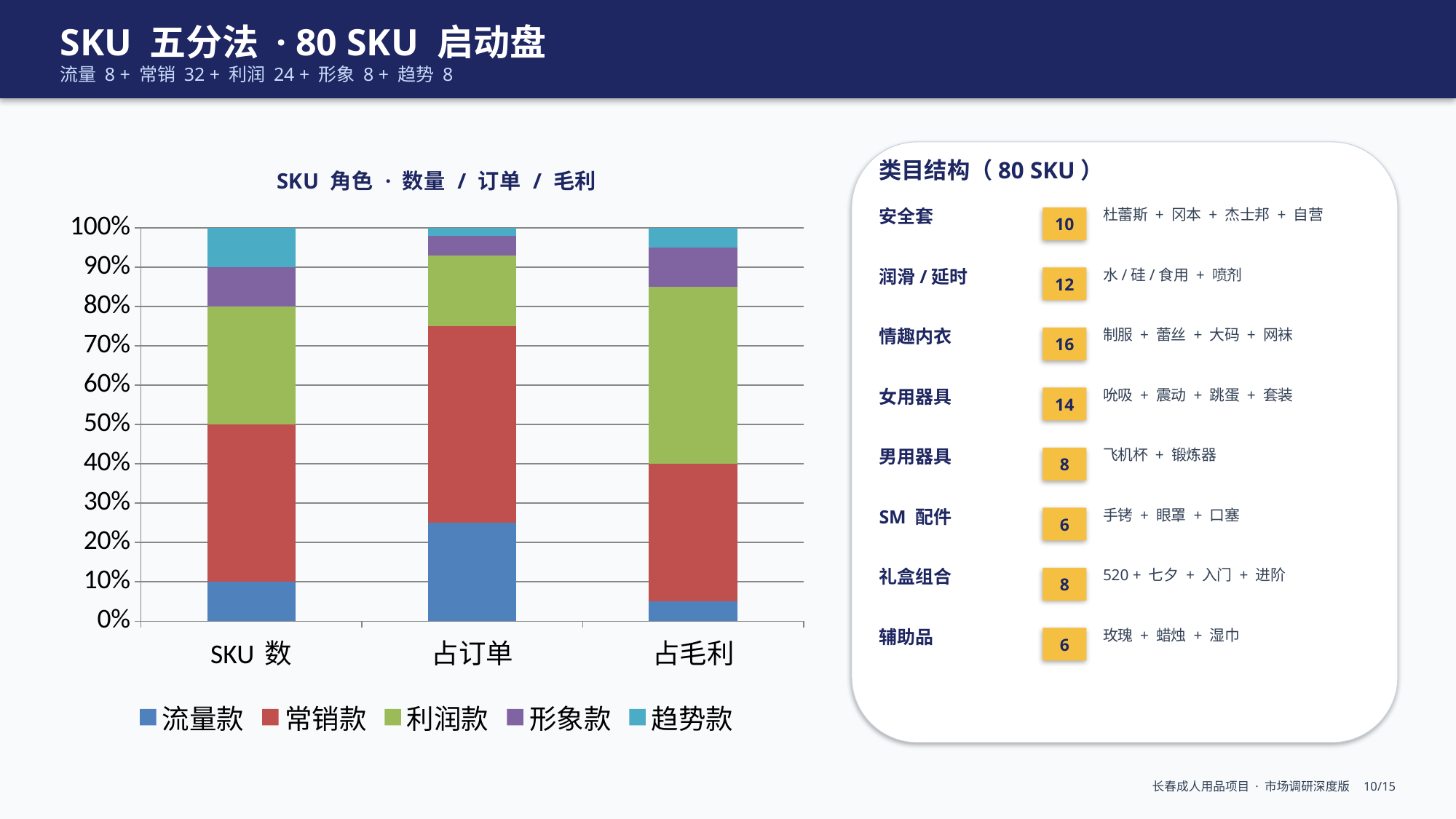
What kind of chart is shown on the slide? Stacked bar chart In the 占毛利 bar, is the 流量款 segment greater or less than 10%? less What is the title of the chart? SKU 角色 · 数量 / 订单 / 毛利 Which category has the largest 流量款 segment? 占订单 In the 占订单 bar, is the 常销款 segment greater or less than 40%? greater Is the 利润款 segment larger in the 占毛利 bar or in the 占订单 bar? 占毛利 How many categories are shown on the x axis of the chart? 3 Which series is listed first in the chart legend? 流量款 How many series does the chart legend list? 5 Is the 流量款 segment larger in the 占订单 bar or in the SKU 数 bar? 占订单 In the 占订单 bar, is the 流量款 segment greater or less than 20%? greater Which category has the smallest 流量款 segment? 占毛利